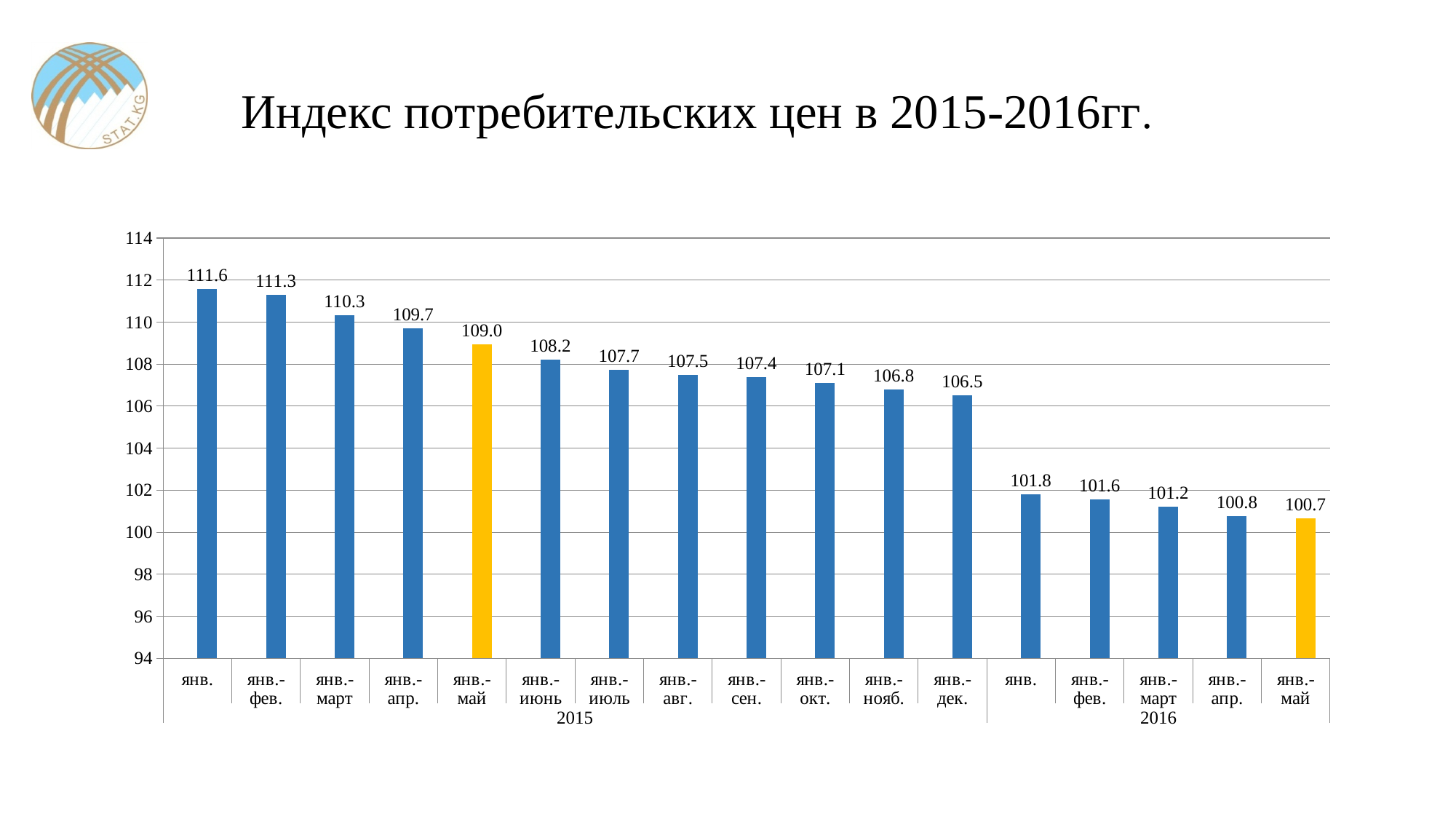
What is the value for янв.-май 2015? 109.0 Which is larger, the value for янв.-март 2015 or the value for янв.-март 2016? янв.-март 2015 Is the value for янв.-июнь 2015 greater or less than 106? greater What is the title of the chart? Индекс потребительских цен в 2015-2016гг. Which category has the highest value? янв. 2015 What is the value for янв.-дек. 2015? 106.5 How many bars are plotted on the chart? 17 Which category has the lowest value? янв.-май 2016 What is the difference between the values for янв.-май 2015 and янв.-май 2016? 8.3 What kind of chart is shown on the slide? bar chart What is the value for янв.-май 2016? 100.7 Do the values rise or fall from left to right along the x axis? fall